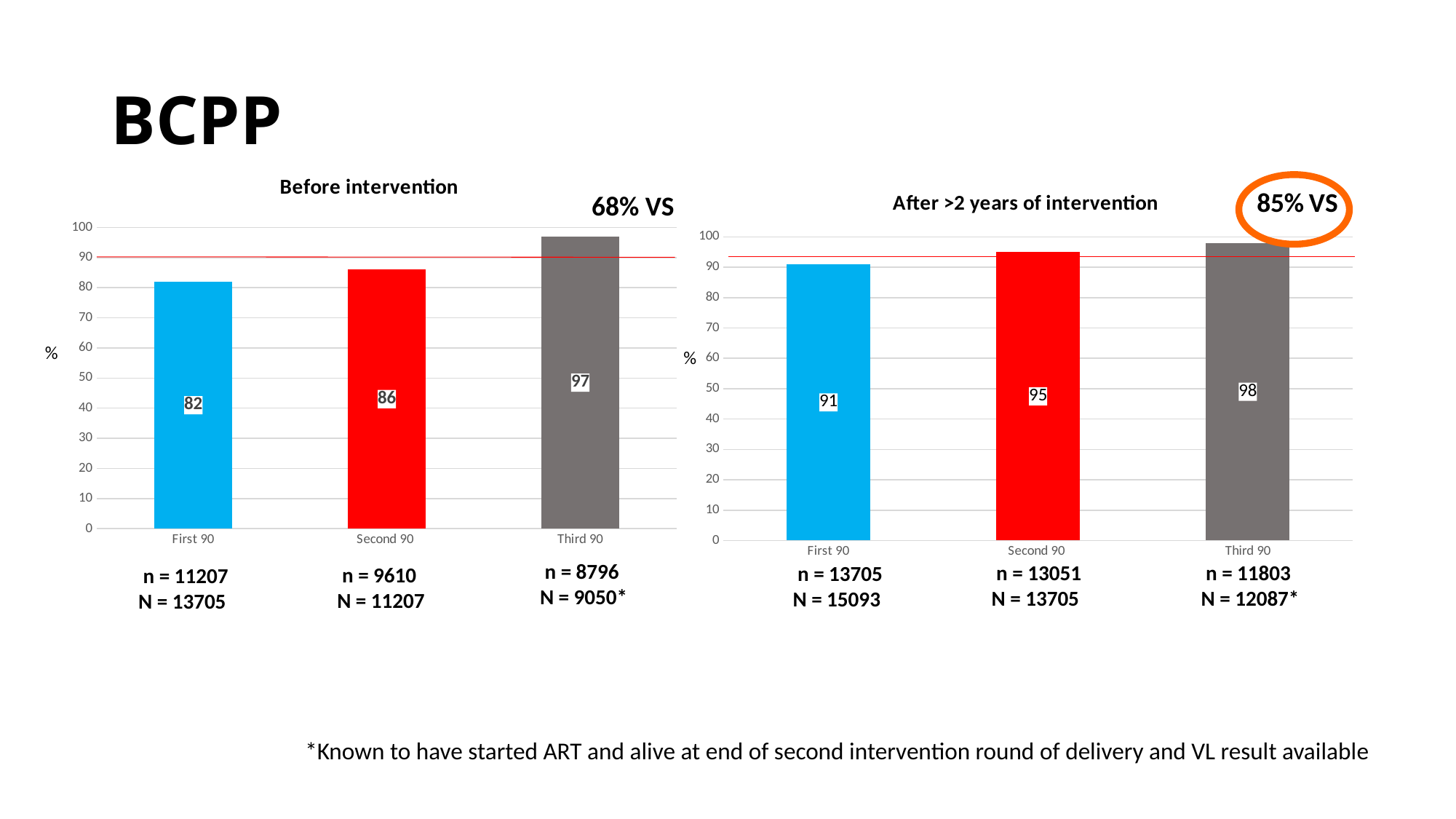
In the 'Before intervention' chart, which category has the lowest value? First 90 Which is larger: the value for First 90 in the 'Before intervention' chart or the value for First 90 in the 'After >2 years of intervention' chart? After >2 years of intervention In the 'Before intervention' chart, what is the value for Second 90? 86 In the 'Before intervention' chart, is the value for First 90 greater or less than 90? less In the 'After >2 years of intervention' chart, what is the value for First 90? 91 What kind of chart is the 'Before intervention' chart? bar chart In the 'Before intervention' chart, what is the difference between the values for Third 90 and First 90? 15 In the 'After >2 years of intervention' chart, what is the difference between the values for Second 90 and First 90? 4 In the 'After >2 years of intervention' chart, do the values rise or fall from First 90 to Third 90? rise In the 'After >2 years of intervention' chart, which category has the highest value? Third 90 How many categories are shown in the 'After >2 years of intervention' chart? 3 What is the title of the chart on the right side of the slide? After >2 years of intervention